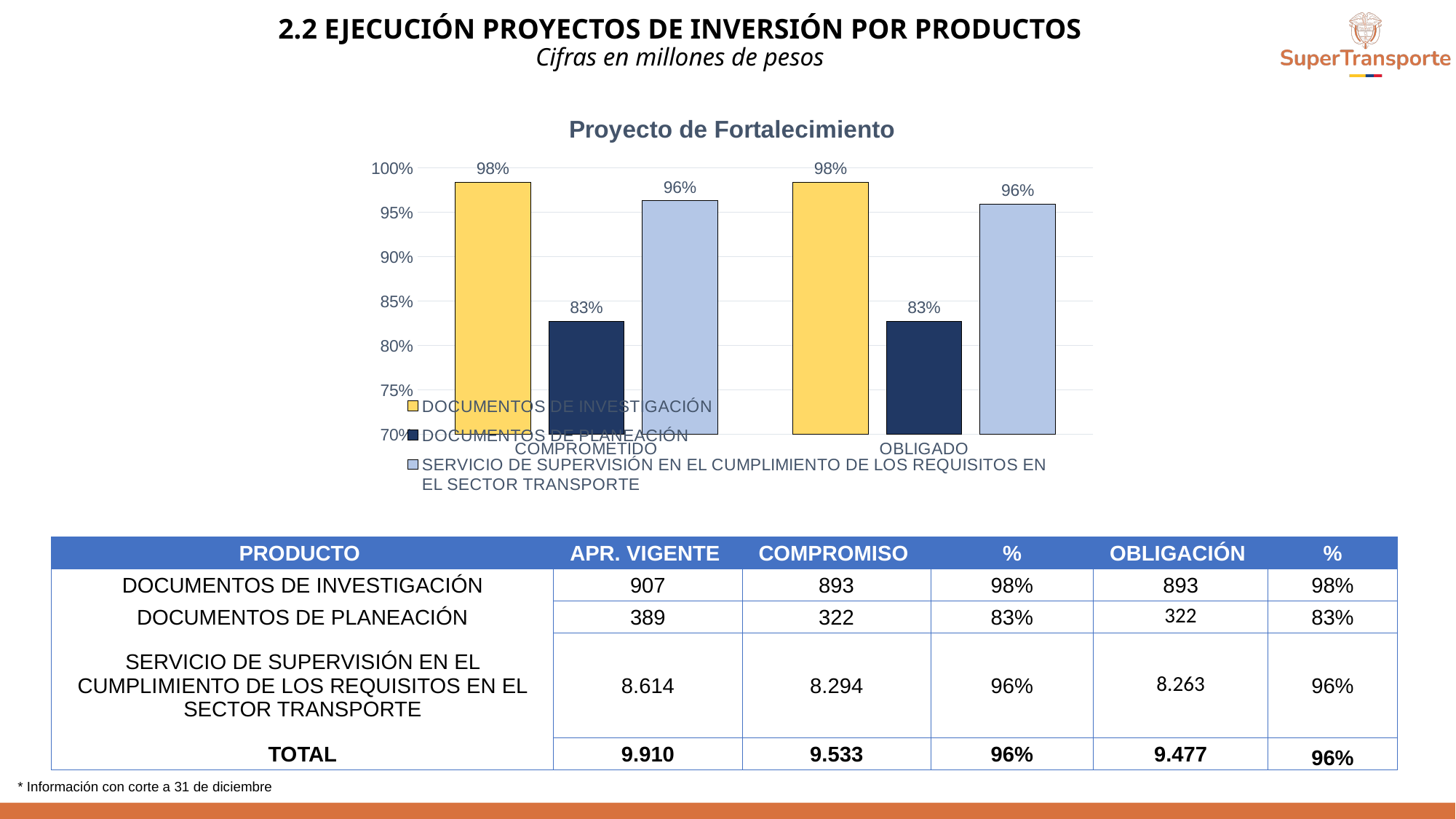
Which series has the highest value in the COMPROMETIDO category? DOCUMENTOS DE INVESTIGACIÓN How many series does the chart legend list? 3 What is the value for SERVICIO DE SUPERVISIÓN EN EL CUMPLIMIENTO DE LOS REQUISITOS EN EL SECTOR TRANSPORTE in the COMPROMETIDO category? 96% How many categories are shown on the x axis of the chart? 2 What is the value for DOCUMENTOS DE PLANEACIÓN in the OBLIGADO category? 83% What type of chart is shown on the slide? bar chart In the OBLIGADO category, which is larger: the value for DOCUMENTOS DE PLANEACIÓN or the value for SERVICIO DE SUPERVISIÓN EN EL CUMPLIMIENTO DE LOS REQUISITOS EN EL SECTOR TRANSPORTE? SERVICIO DE SUPERVISIÓN EN EL CUMPLIMIENTO DE LOS REQUISITOS EN EL SECTOR TRANSPORTE What is the title of the chart? Proyecto de Fortalecimiento What is the value for DOCUMENTOS DE INVESTIGACIÓN in the COMPROMETIDO category? 98% What is the difference between the DOCUMENTOS DE INVESTIGACIÓN value and the DOCUMENTOS DE PLANEACIÓN value in the COMPROMETIDO category? 15% Which series has the lowest value in the OBLIGADO category? DOCUMENTOS DE PLANEACIÓN Is the value for DOCUMENTOS DE PLANEACIÓN in the COMPROMETIDO category greater or less than 90%? less